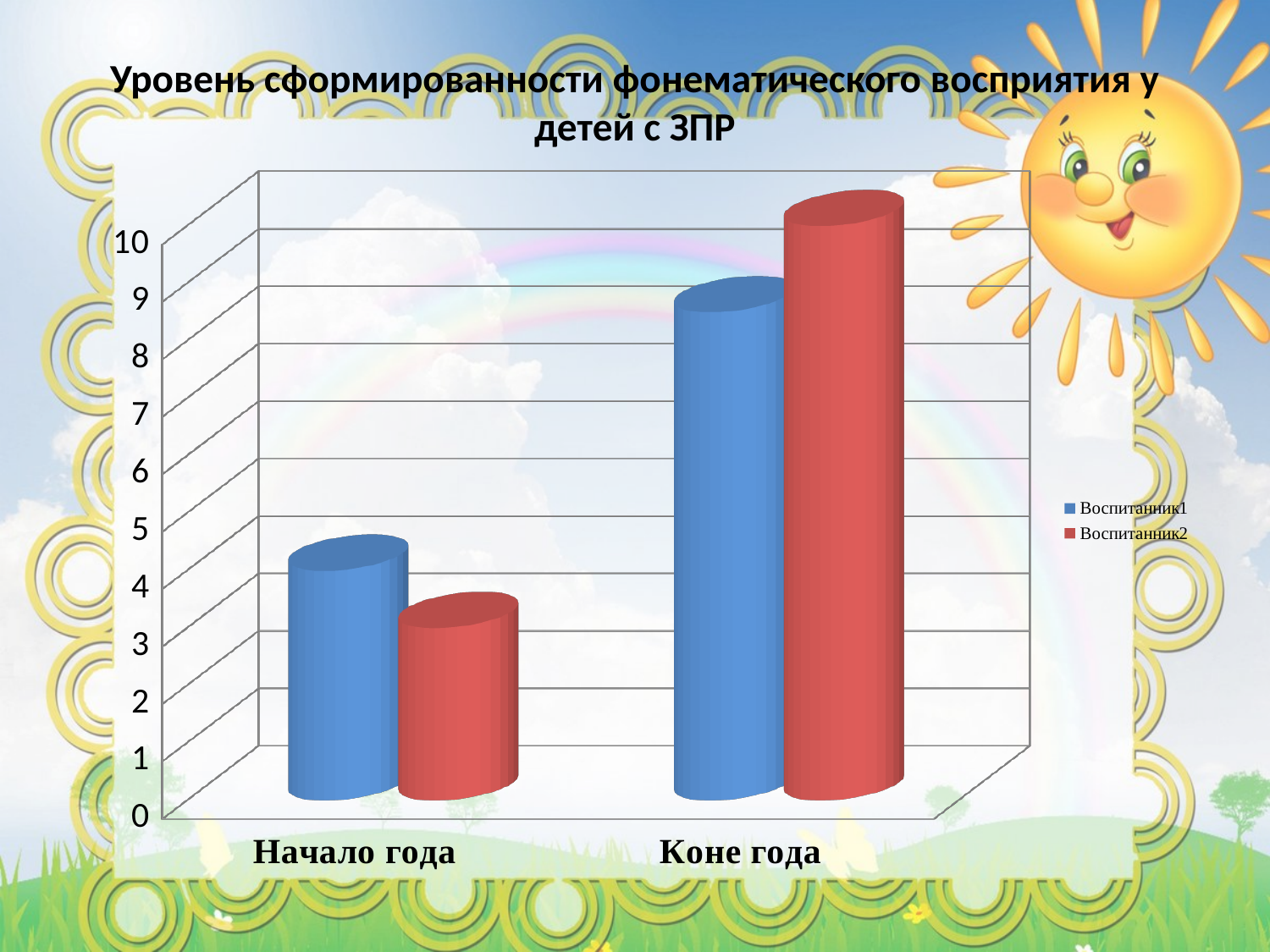
Which bar is the shortest in the chart? Воспитанник2 at Начало года Is the value for Воспитанник2 at Коне года greater or less than 7? greater At Начало года, which is larger: Воспитанник1 or Воспитанник2? Воспитанник1 Is the value for Воспитанник1 at Начало года greater or less than 6? less What kind of chart is shown on the slide? bar chart Which series is shown in red? Воспитанник2 At Коне года, which is larger: Воспитанник1 or Воспитанник2? Воспитанник2 How many series does the legend list? 2 How many categories are shown on the x axis? 2 What is the title of the chart? Уровень сформированности фонематического восприятия у детей с ЗПР Do the values for Воспитанник1 rise or fall from Начало года to Коне года? rise Which bar is the tallest in the chart? Воспитанник2 at Коне года